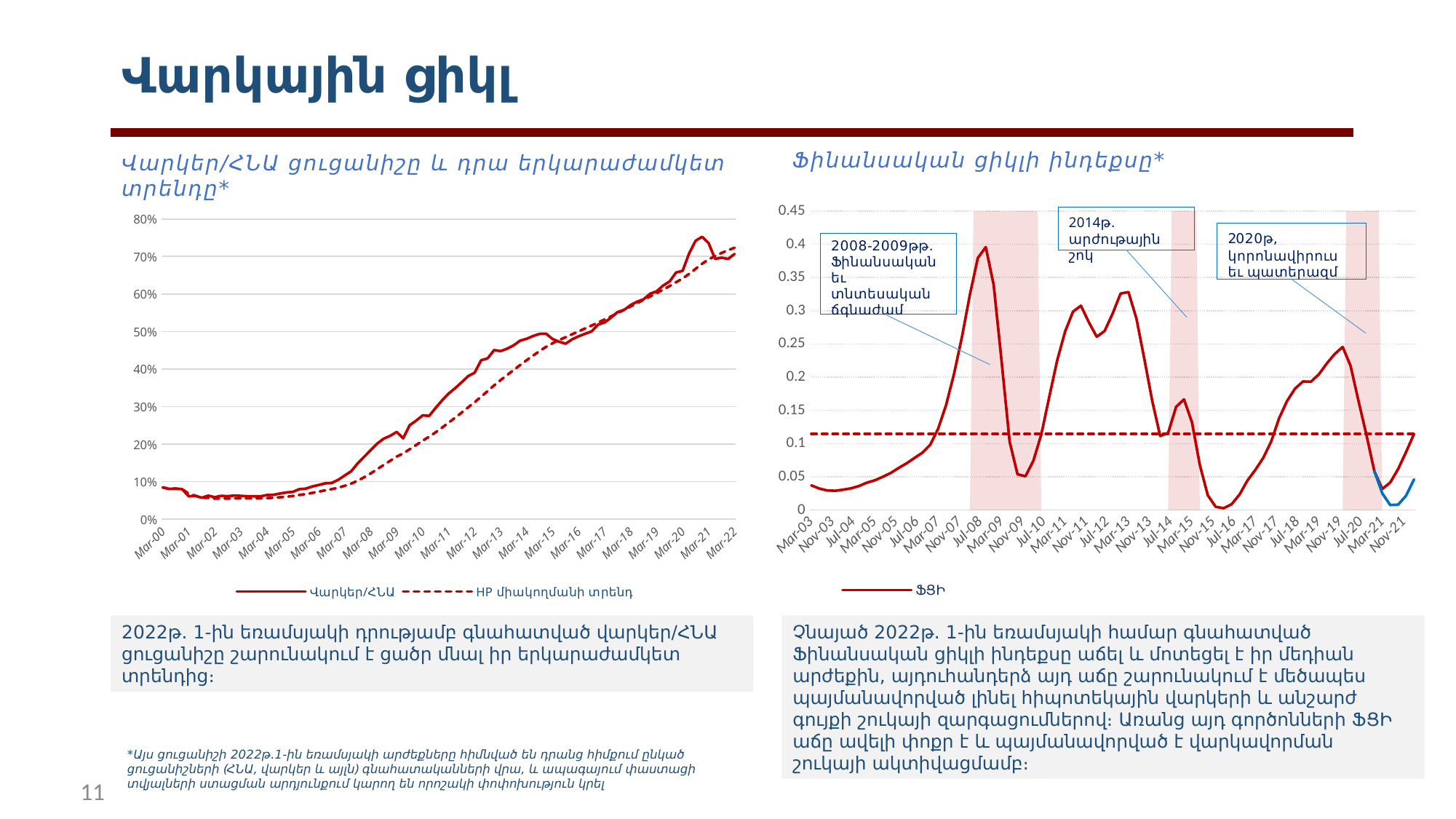
In the left chart, is the Վարկեր/ՀՆԱ value at Mar-00 greater or less than 20%? less In the right chart, is the ՖՑԻ peak around Jul-08 greater or less than 0.3? greater In the left chart, what are the two legend entries? Վարկեր/ՀՆԱ and HP միակողմանի տրենդ In the left chart, does the Վարկեր/ՀՆԱ line overall rise or fall from Mar-00 to Mar-22? Rise In the left chart, is the Վարկեր/ՀՆԱ value at Mar-22 greater or less than 60%? greater What kind of chart is the right chart titled "Ֆինանսական ցիկլի ինդեքսը*"? Line chart What kind of chart is the left chart titled "Վարկեր/ՀՆԱ ցուցանիշը և դրա երկարաժամկետ տրենդը*"? Line chart In the right chart, what is the legend entry for the plotted line? ՖՑԻ In the right chart, which ՖՑԻ peak is higher: the one around Jul-08 or the one around Mar-13? The one around Jul-08 How many series does the legend of the right chart list? 1 How many series does the legend of the left chart list? 2